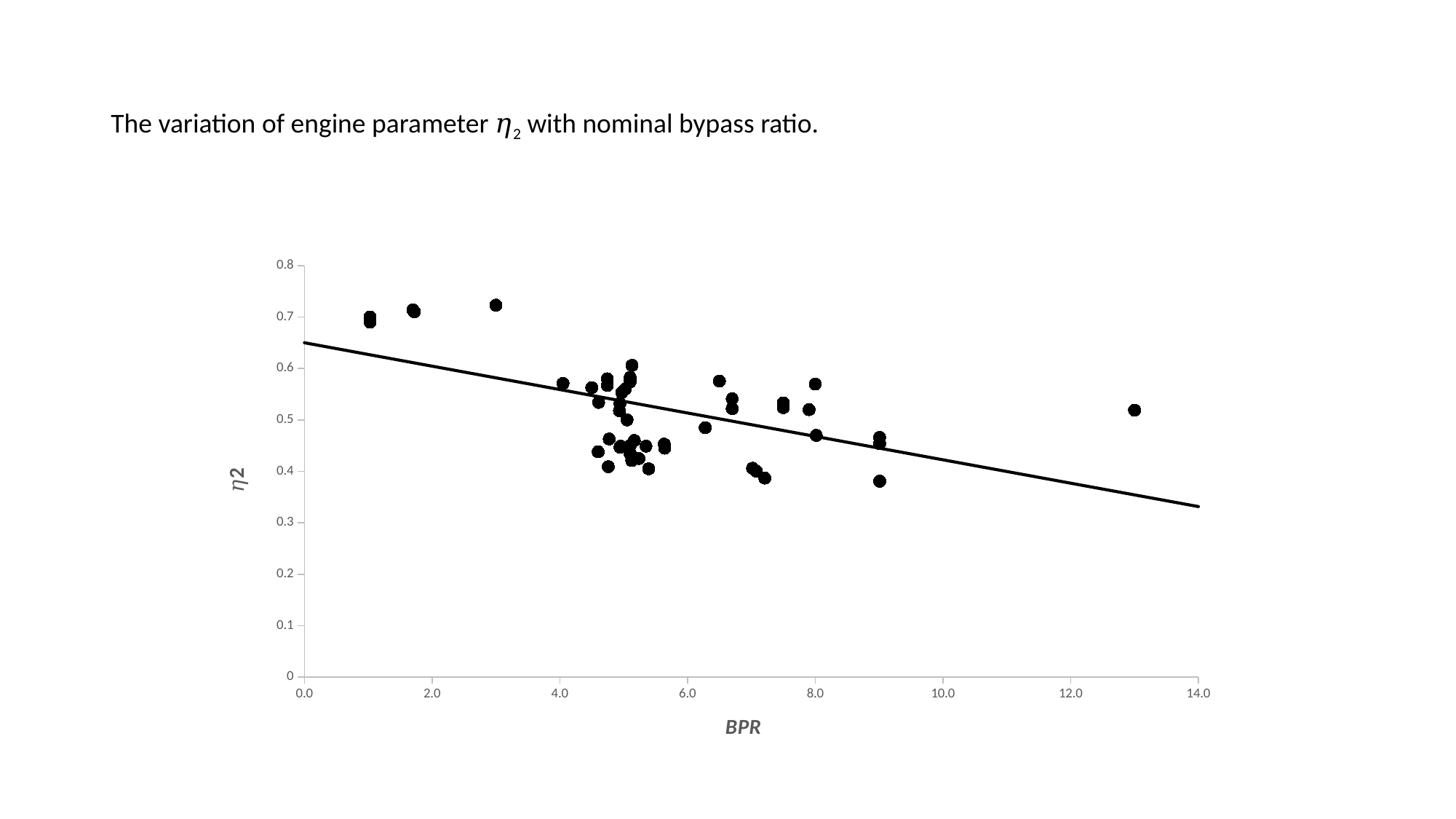
Is the η2 value of the point at BPR 13.0 greater or less than 0.4? greater What is the label of the x axis? BPR What is the highest value shown on the x axis? 14.0 According to the trend line, do the η2 values rise or fall as BPR increases? fall What kind of chart is shown on the slide? scatter plot Is the trend line's η2 value at BPR 14.0 greater or less than 0.4? less Is the η2 value of the point at BPR 13.0 greater or less than 0.6? less